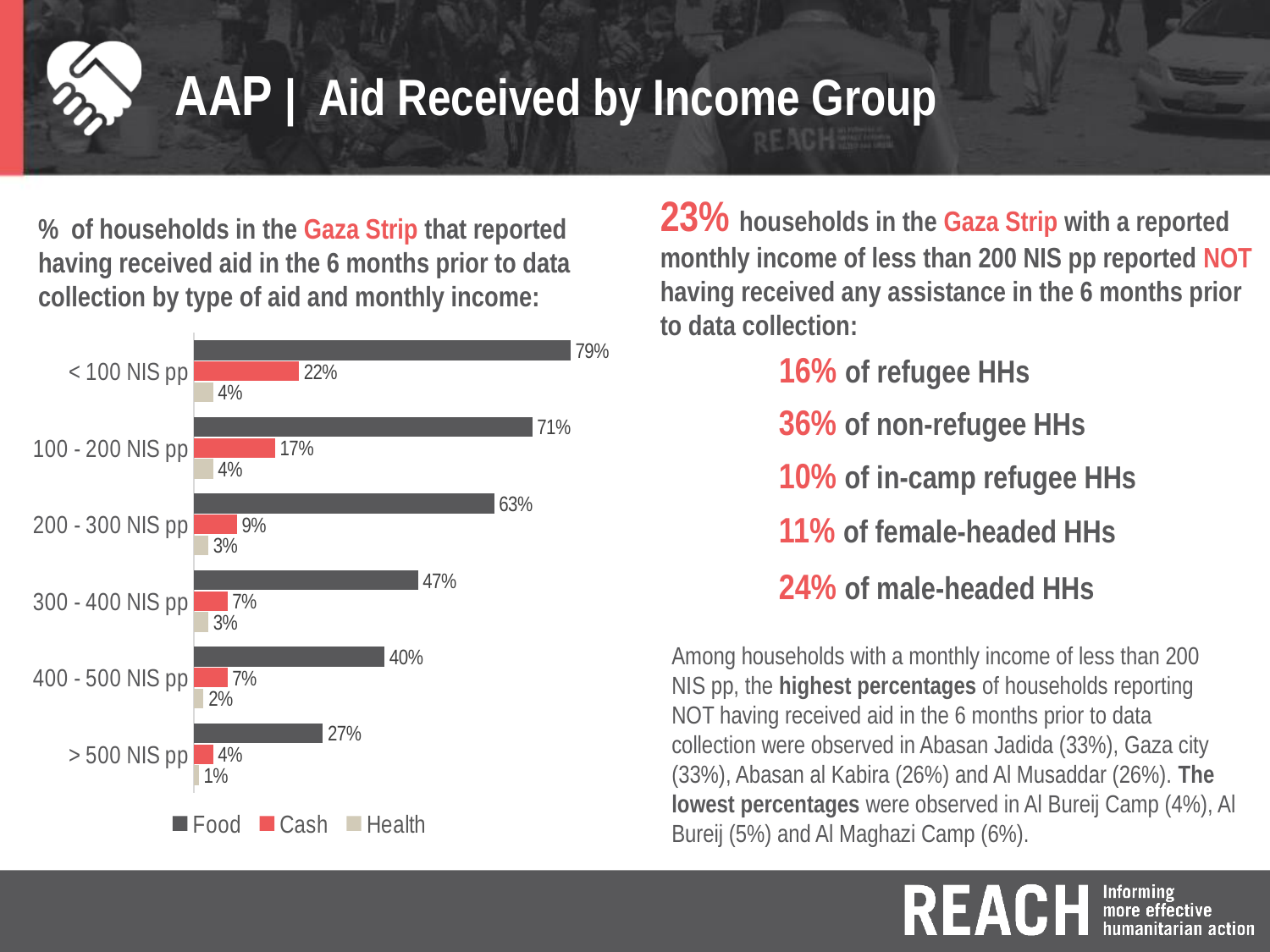
What percentage of households with income 100 - 200 NIS pp reported receiving Cash aid? 17% How does the percentage of households receiving Food aid change as monthly income increases? It falls Which income group has the lowest percentage of households receiving Cash aid? > 500 NIS pp How many series does the chart legend list? 3 What percentage of households with income < 100 NIS pp reported receiving Food aid? 79% How many income groups are shown in the chart? 6 Which is larger: the Cash aid percentage for 200 - 300 NIS pp or for 300 - 400 NIS pp? 200 - 300 NIS pp What percentage of households with income > 500 NIS pp reported receiving Health aid? 1% What is the difference between the Food aid percentages for the < 100 NIS pp and > 500 NIS pp groups? 52 percentage points Which series is shown in red in the chart? Cash What type of chart is used to show aid received by income group? Bar chart Which income group has the highest percentage of households receiving Food aid? < 100 NIS pp